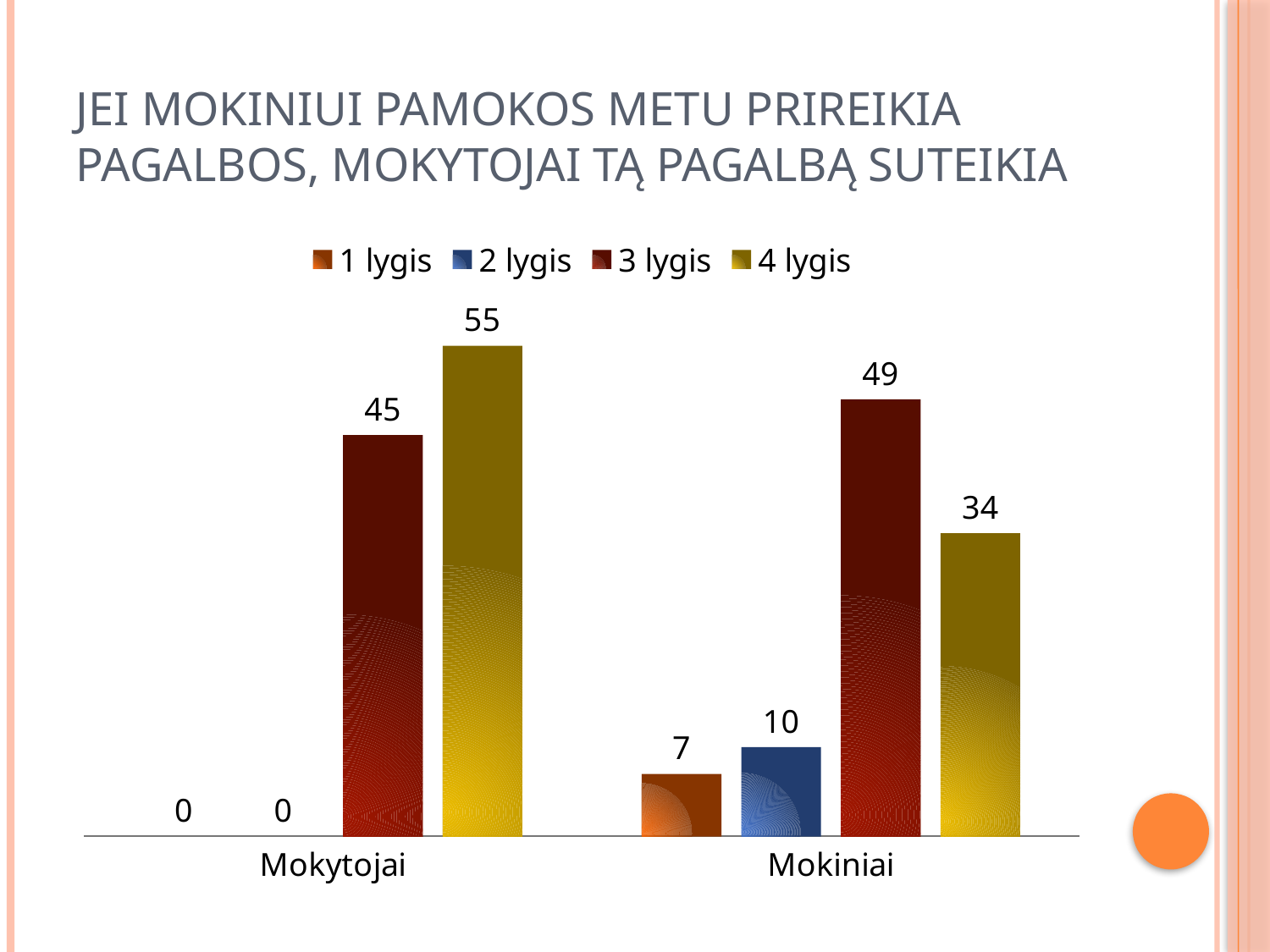
What is the difference between the 4 lygis values for Mokytojai and Mokiniai? 21 What is the value for 4 lygis in the Mokytojai category? 55 What is the difference between the 3 lygis and 4 lygis values in the Mokiniai category? 15 How many series does the legend list? 4 What is the value for 1 lygis in the Mokiniai category? 7 Which series has the highest value in the Mokiniai category? 3 lygis What is the value for 2 lygis in the Mokytojai category? 0 Which series has the highest value in the Mokytojai category? 4 lygis What kind of chart is shown on the slide? Bar chart How many categories are shown on the x axis? 2 What is the value for 3 lygis in the Mokiniai category? 49 Which is larger: the 3 lygis value for Mokytojai or the 3 lygis value for Mokiniai? Mokiniai